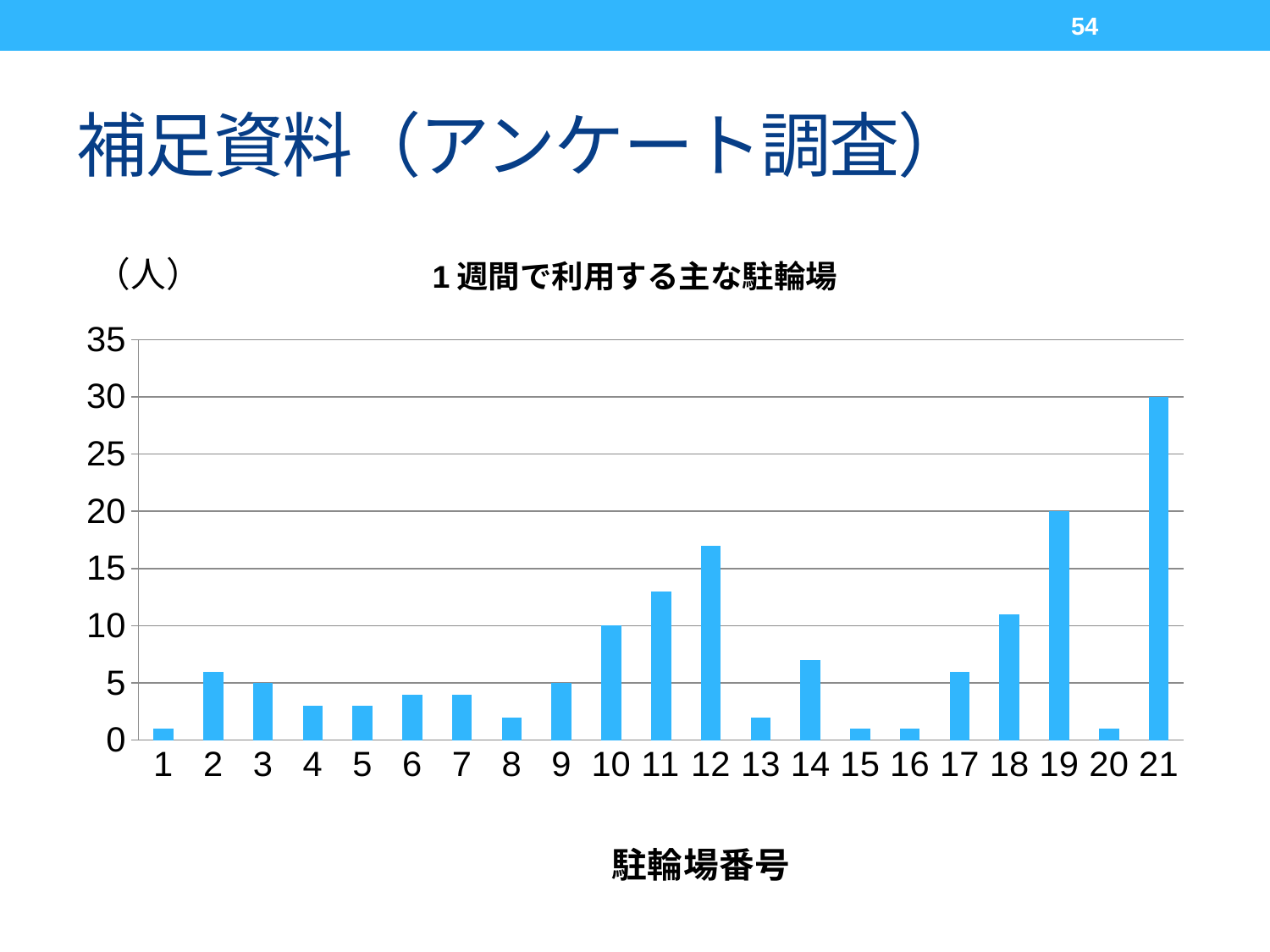
Which parking lot number has the highest value? 21 Is the value for parking lot number 13 greater or less than 5? less What kind of chart is shown on the slide? bar chart What is the value for parking lot number 19? 20 Is the value for parking lot number 12 greater or less than 15? greater What is the title of the chart? １週間で利用する主な駐輪場 Which has a larger value, parking lot 12 or parking lot 19? 19 What is the difference between the values for parking lot 21 and parking lot 19? 10 What is the value for parking lot number 10? 10 What is the value for parking lot number 21? 30 Is the value for parking lot number 18 greater or less than 10? greater How many parking lot numbers (categories) are shown on the x axis? 21